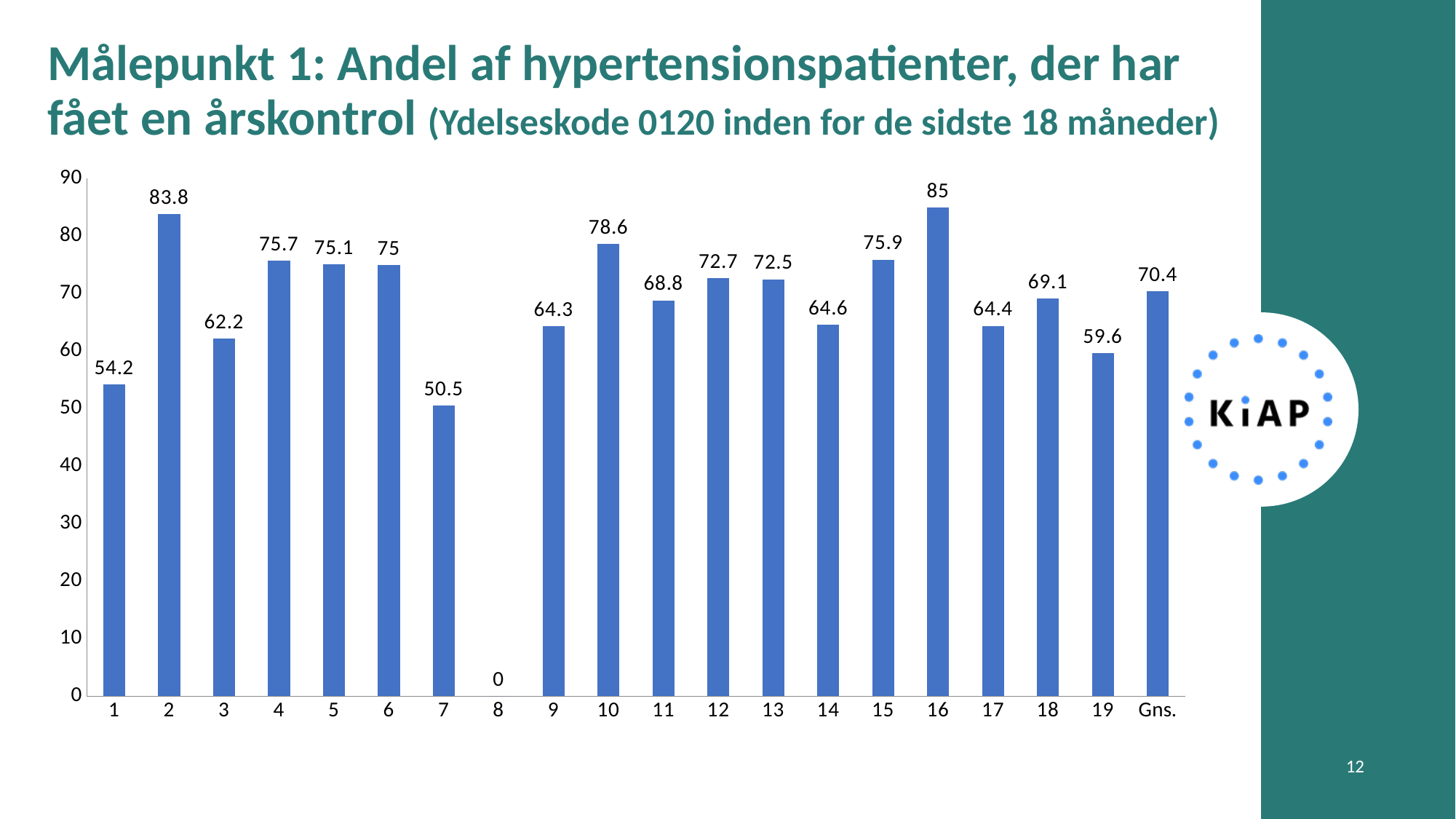
Which category has the highest value? 16 What is the value for category 7? 50.5 How many categories are shown on the x axis? 20 What is the difference between the values for category 16 and category 2? 1.2 Is the value for category 1 greater or less than 60? less Which is larger, the value for category 3 or the value for category 19? 3 What is the difference between the value for category 10 and the Gns. value? 8.2 What is the value for category 2? 83.8 What is the label of the last category on the x axis? Gns. Which category has the lowest value? 8 What is the value for Gns.? 70.4 What kind of chart is shown on the slide? bar chart